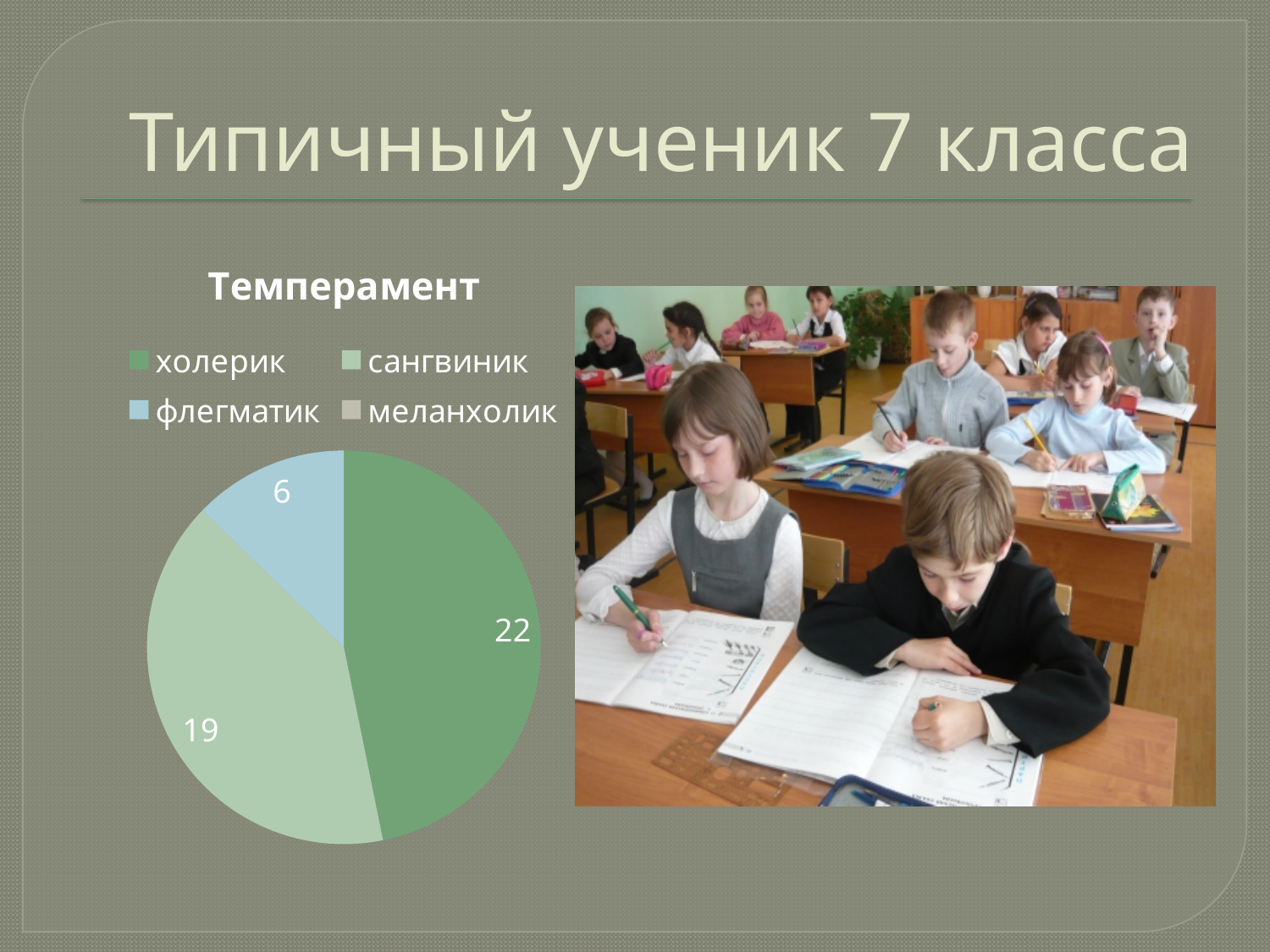
What is the value for флегматик in the pie chart? 6 What is the difference between the values for сангвиник and флегматик? 13 What is the difference between the values for холерик and сангвиник? 3 What kind of chart is shown on the slide? pie chart Which is larger, the value for холерик or the value for флегматик? холерик Which category has the smallest visible slice in the pie chart? флегматик How many slices with data labels are visible in the pie chart? 3 Which category has the largest slice in the pie chart? холерик What is the value for холерик in the pie chart? 22 How many entries does the chart legend list? 4 What is the value for сангвиник in the pie chart? 19 What is the title of the chart? Темперамент